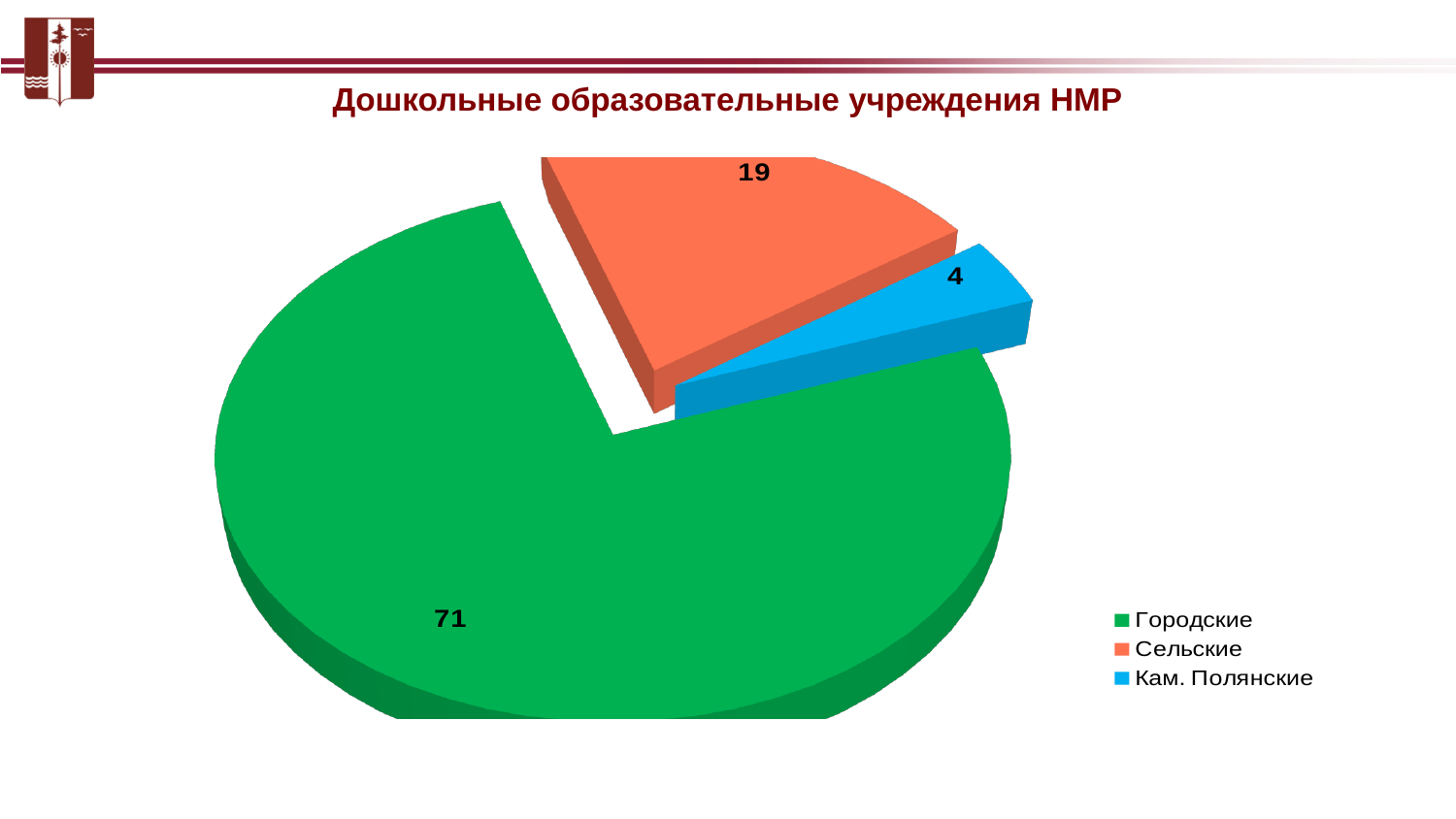
What is the title of the chart? Дошкольные образовательные учреждения НМР What is the total of all the slices in the pie chart? 94 What is the difference between the values for Городские and Сельские? 52 What is the value for Кам. Полянские? 4 What is the difference between the values for Сельские and Кам. Полянские? 15 How many categories does the pie chart have? 3 Which category has the smallest slice of the pie? Кам. Полянские What is the value for Городские? 71 What is the value for Сельские? 19 What kind of chart is shown on the slide? Pie chart Which is larger, the value for Сельские or the value for Кам. Полянские? Сельские Which category has the largest slice of the pie? Городские